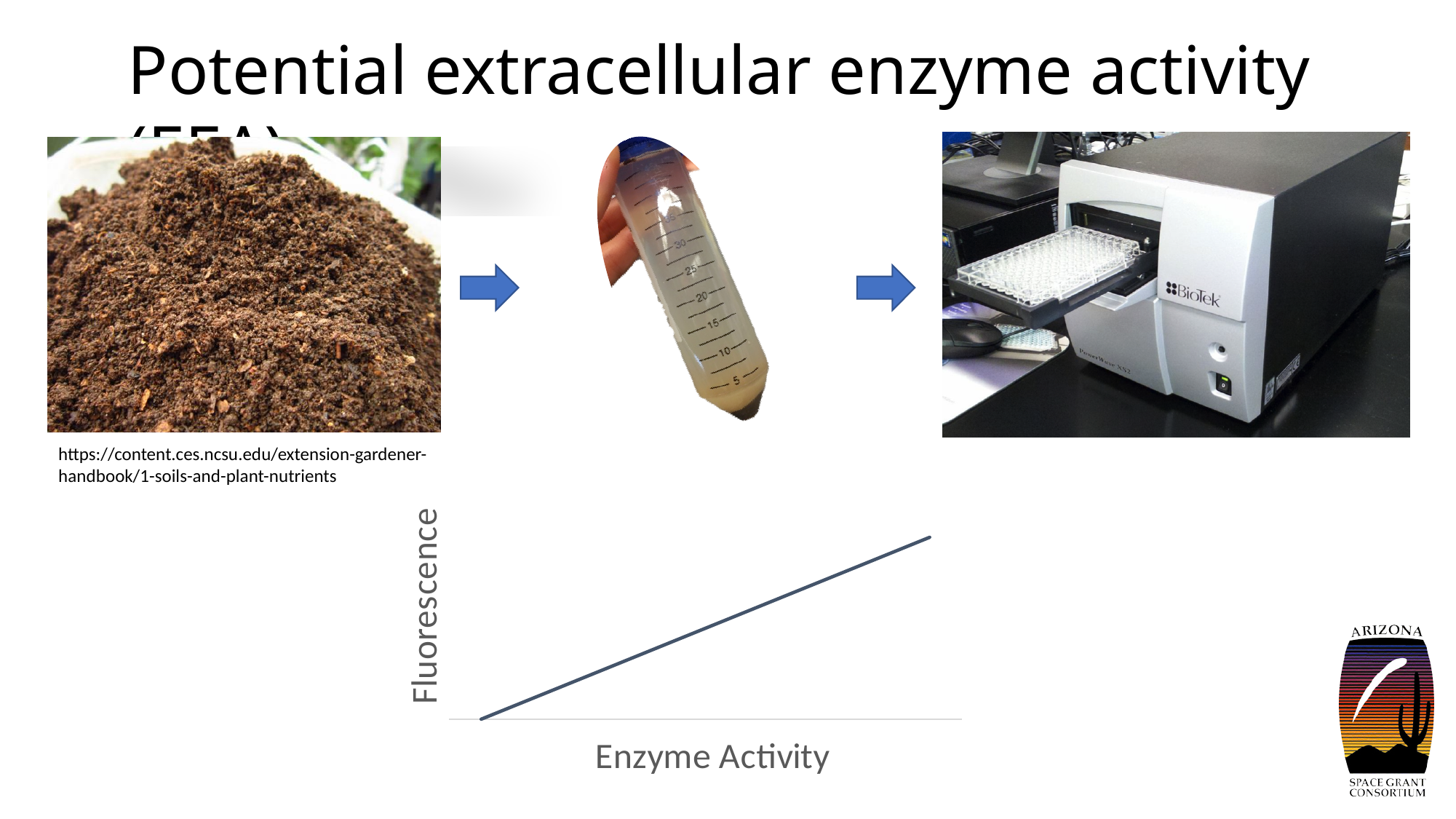
How many lines are plotted in the chart? 1 What kind of chart is shown at the bottom of the slide? line chart What is the label on the horizontal axis of the chart? Enzyme Activity What is the label on the vertical axis of the chart? Fluorescence Does the line in the chart rise or fall as enzyme activity increases along the x axis? rise